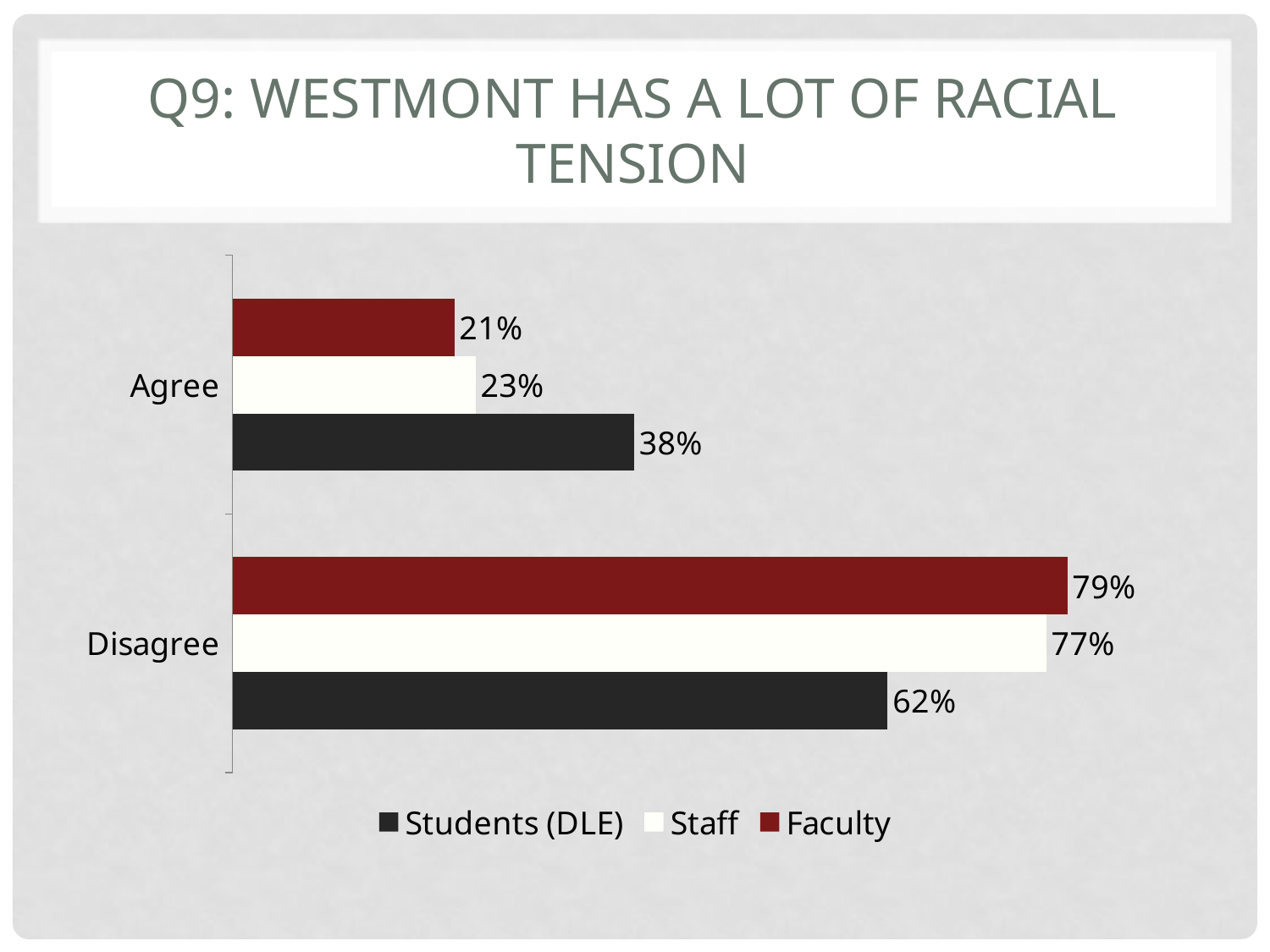
Which is larger: the Staff percentage for Disagree or the Students (DLE) percentage for Disagree? Staff Which group has the highest percentage agreeing with the statement? Students (DLE) How many series does the legend list? 3 What percentage of Staff agree with the statement? 23% What percentage of Faculty disagree that Westmont has a lot of racial tension? 79% What percentage of Students (DLE) agree that Westmont has a lot of racial tension? 38% What is the title of the chart on the slide? Q9: Westmont has a lot of racial tension What kind of chart is shown on the slide? Bar chart What percentage of Staff disagree with the statement? 77% What is the difference between the Students (DLE) and Faculty percentages for Agree? 17% Which group has the lowest percentage agreeing with the statement? Faculty What is the difference between the Faculty and Students (DLE) percentages for Disagree? 17%